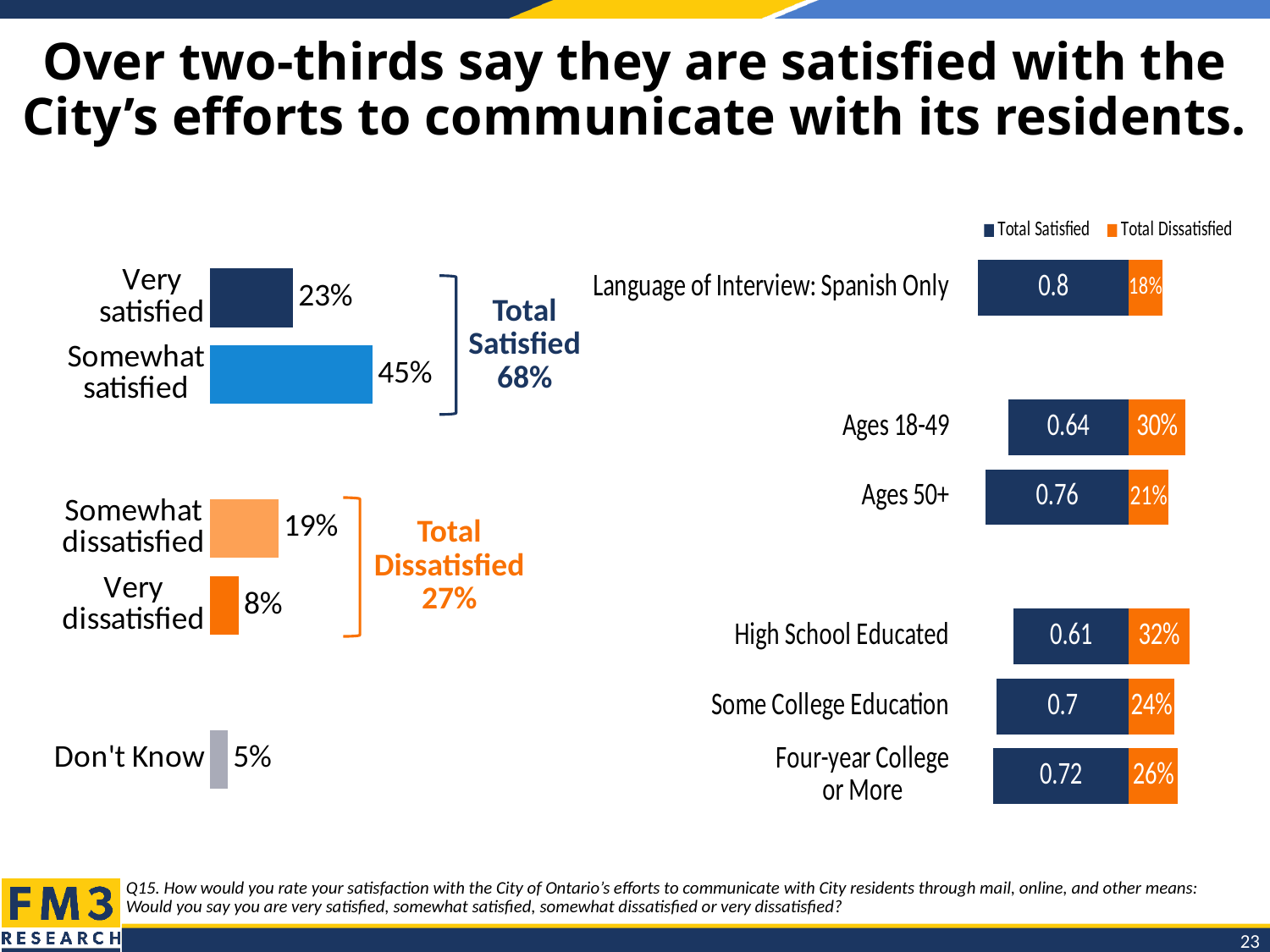
On the left chart, what is the difference between the somewhat satisfied and very satisfied percentages? 22% On the right chart, how many series does the legend list? 2 On the right chart, what is the Total Dissatisfied value for High School Educated respondents? 32% On the left chart, which category has the lowest value? Don't Know On the left chart, what percentage of respondents are somewhat satisfied? 45% On the left chart, what percentage of respondents are very dissatisfied? 8% On the right chart, is the Total Dissatisfied value larger for Ages 18-49 or Ages 50+? Ages 18-49 On the right chart, which group has the highest Total Satisfied value? Language of Interview: Spanish Only On the left chart, what is the Total Satisfied figure shown? 68% On the left chart, how many categories are shown? 5 On the left chart, which category has the highest value? Somewhat satisfied On the right chart, what is the Total Satisfied value for Ages 18-49? 0.64